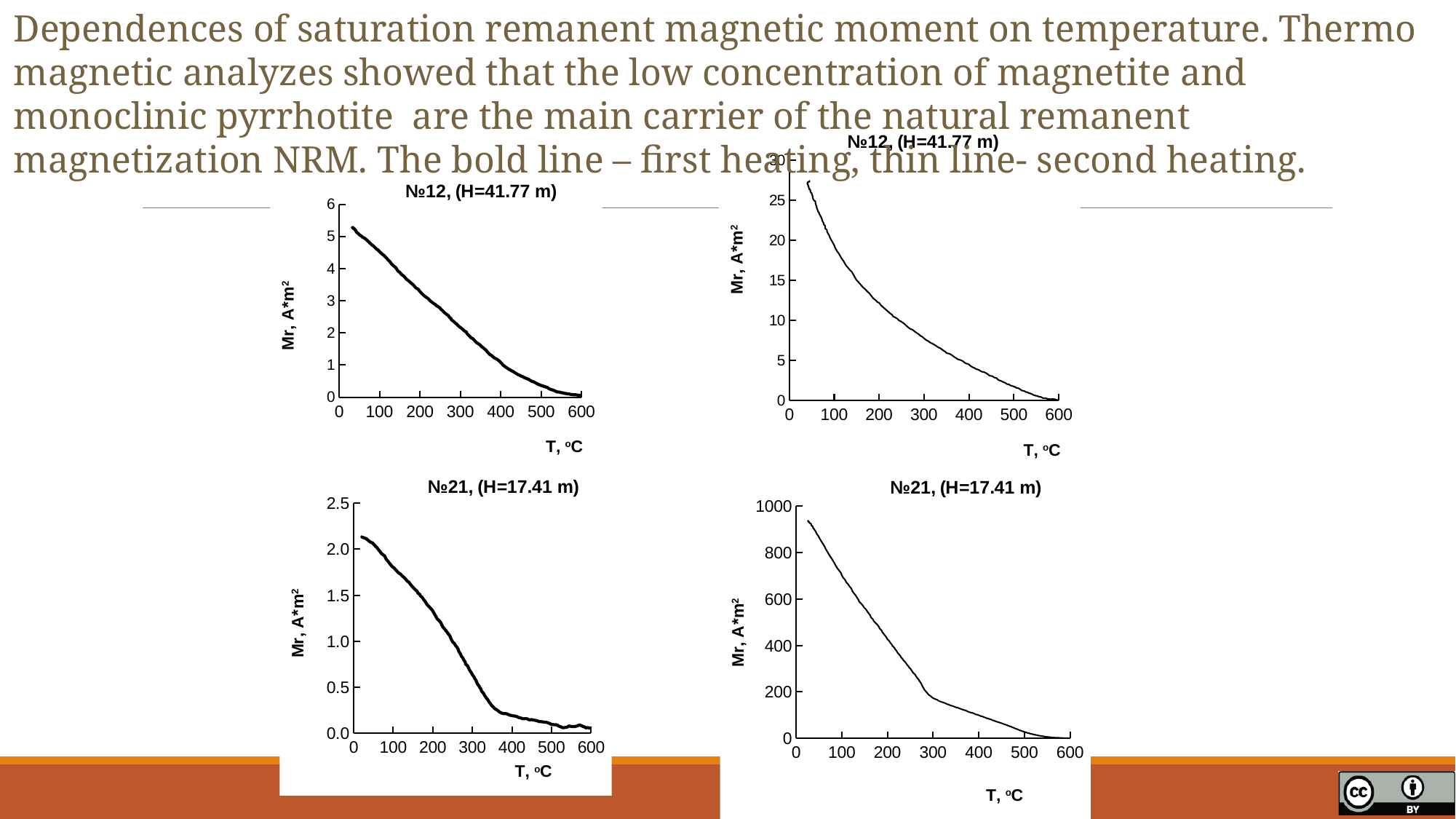
In the bottom-left chart (№21, bold line), is the value at T = 400 °C greater or less than 0.5? less In the bottom-right chart (№21, thin line), is the value at T = 100 °C greater or less than 600? greater What is the y-axis label of the bottom-right chart titled "№21, (H=17.41 m)"? Mr, A*m² What kind of chart is the top-left chart titled "№12, (H=41.77 m)"? line chart How many charts are shown on the slide? 4 In the top-left chart (№12, bold line), is the value at T = 500 °C greater or less than 1? less In the bottom-right chart (№21, thin line), does the value rise or fall as temperature increases? fall In the top-left chart (№12, bold line), does the value rise or fall as temperature increases along the x axis? fall